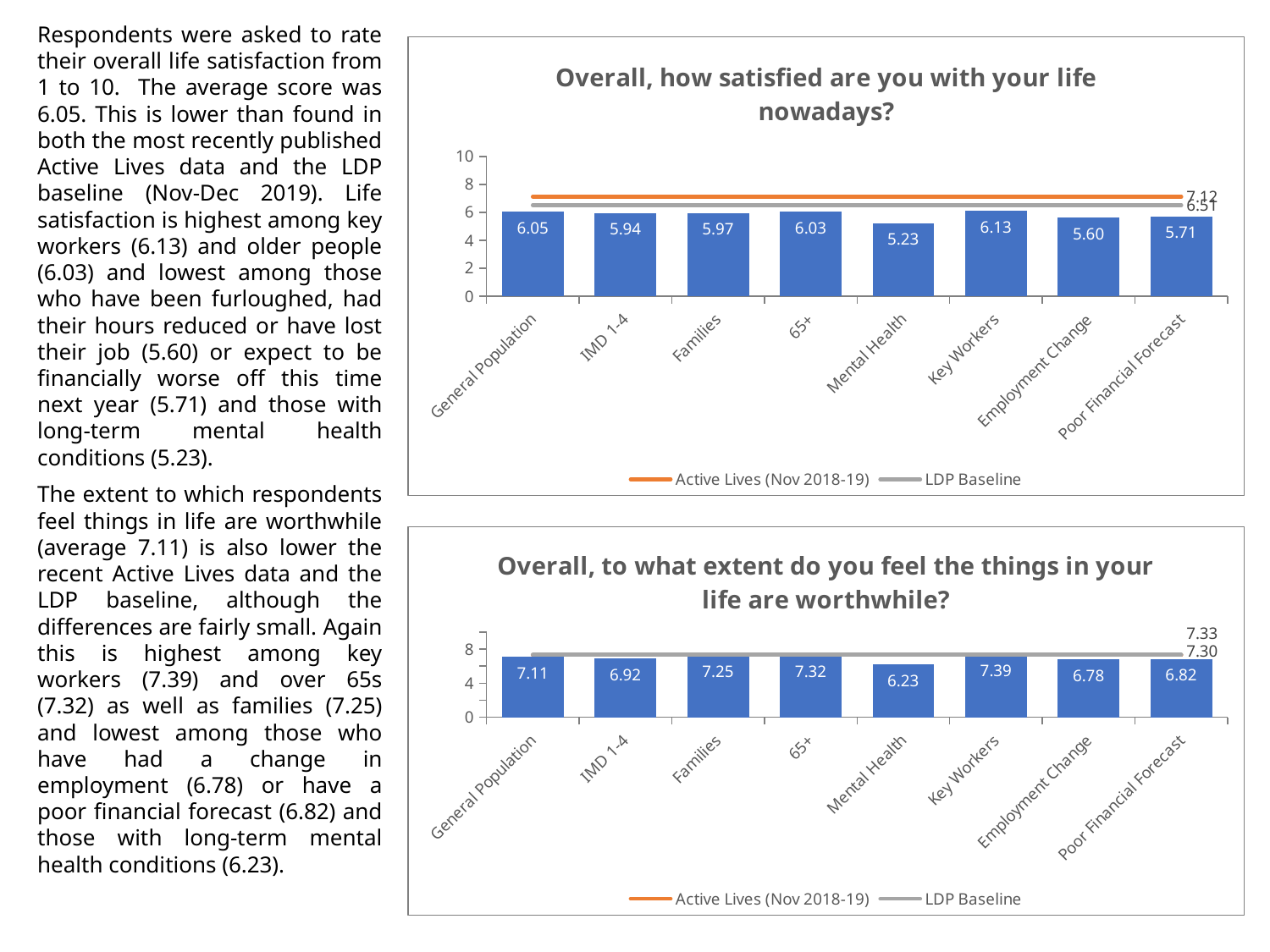
What type of chart is the bottom chart on the slide? Combination bar and line chart In the chart 'Overall, to what extent do you feel the things in your life are worthwhile?', what value is shown for the LDP Baseline line? 7.33 How many entries does the legend of the top chart list? 2 In the chart 'Overall, to what extent do you feel the things in your life are worthwhile?', which category has the highest value? Key Workers In the chart 'Overall, to what extent do you feel the things in your life are worthwhile?', what is the value for Families? 7.25 In the chart 'Overall, how satisfied are you with your life nowadays?', is the value for Employment Change greater or less than 6? less In the chart 'Overall, how satisfied are you with your life nowadays?', which category has the lowest value? Mental Health In the chart 'Overall, how satisfied are you with your life nowadays?', what value is shown for the Active Lives (Nov 2018-19) line? 7.12 In the chart 'Overall, to what extent do you feel the things in your life are worthwhile?', which is larger: the value for 65+ or the value for IMD 1-4? 65+ In the chart 'Overall, how satisfied are you with your life nowadays?', what is the value for Key Workers? 6.13 In the chart 'Overall, how satisfied are you with your life nowadays?', what is the difference between the General Population value and the Mental Health value? 0.82 In the chart 'Overall, how satisfied are you with your life nowadays?', how many categories are shown on the x axis? 8